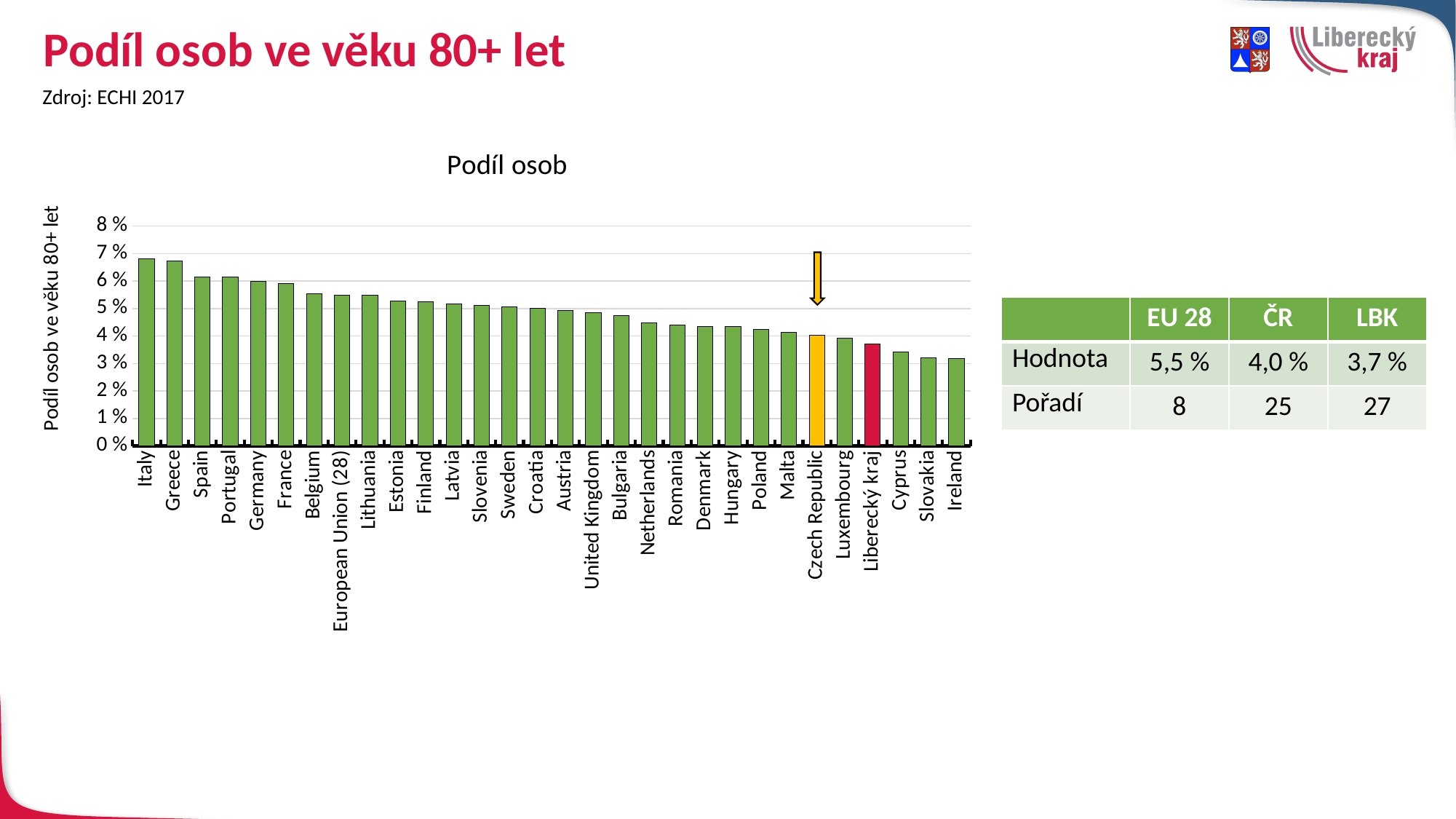
Is the value for Ireland greater or less than 4 %? less What is the difference between the EU 28 value and the ČR value shown in the table? 1,5 % What is the title of the chart? Podíl osob Do the values rise or fall from left to right along the x axis? fall According to the table, what is the value for EU 28? 5,5 % Is the value for Italy greater or less than 6 %? greater What kind of chart is shown on the slide? bar chart According to the table, what is the value for ČR? 4,0 % Which has the larger value, Spain or Cyprus? Spain How many categories (bars) are plotted in the chart? 30 What colour is the bar for Czech Republic? yellow According to the table, what is the value for LBK? 3,7 %